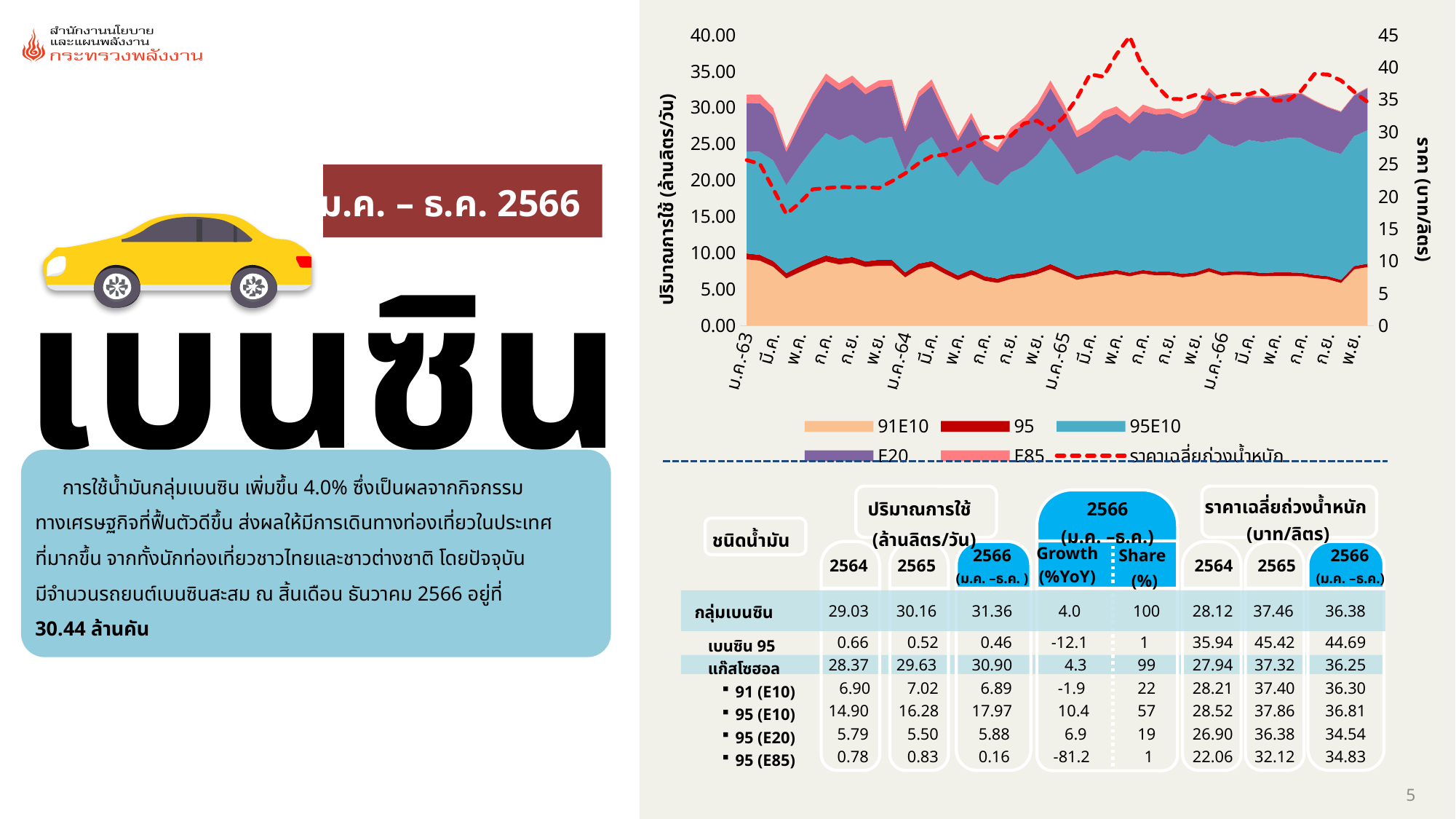
Is the total stacked consumption at พ.ค.-63 greater or less than 30.00 on the left axis? less How many series does the chart legend list? 6 Is the value of the dashed ราคาเฉลี่ยถ่วงน้ำหนัก line at ม.ค.-63 greater or less than 20 on the right axis? greater What is the highest tick value shown on the left vertical axis of the chart? 40.00 Which series in the chart is the largest stacked area at พ.ย.-66: 91E10 or 95E10? 95E10 What is the label of the right vertical axis of the chart? ราคา (บาท/ลิตร) What is the label of the left vertical axis of the chart? ปริมาณการใช้ (ล้านลิตร/วัน) Is the value of the dashed ราคาเฉลี่ยถ่วงน้ำหนัก line at พ.ค.-65 greater or less than 40 on the right axis? greater What kind of chart is shown on the right side of the slide? stacked area chart with a line Does the dashed ราคาเฉลี่ยถ่วงน้ำหนัก line rise or fall overall between มี.ค.-63 and พ.ค.-65? rises